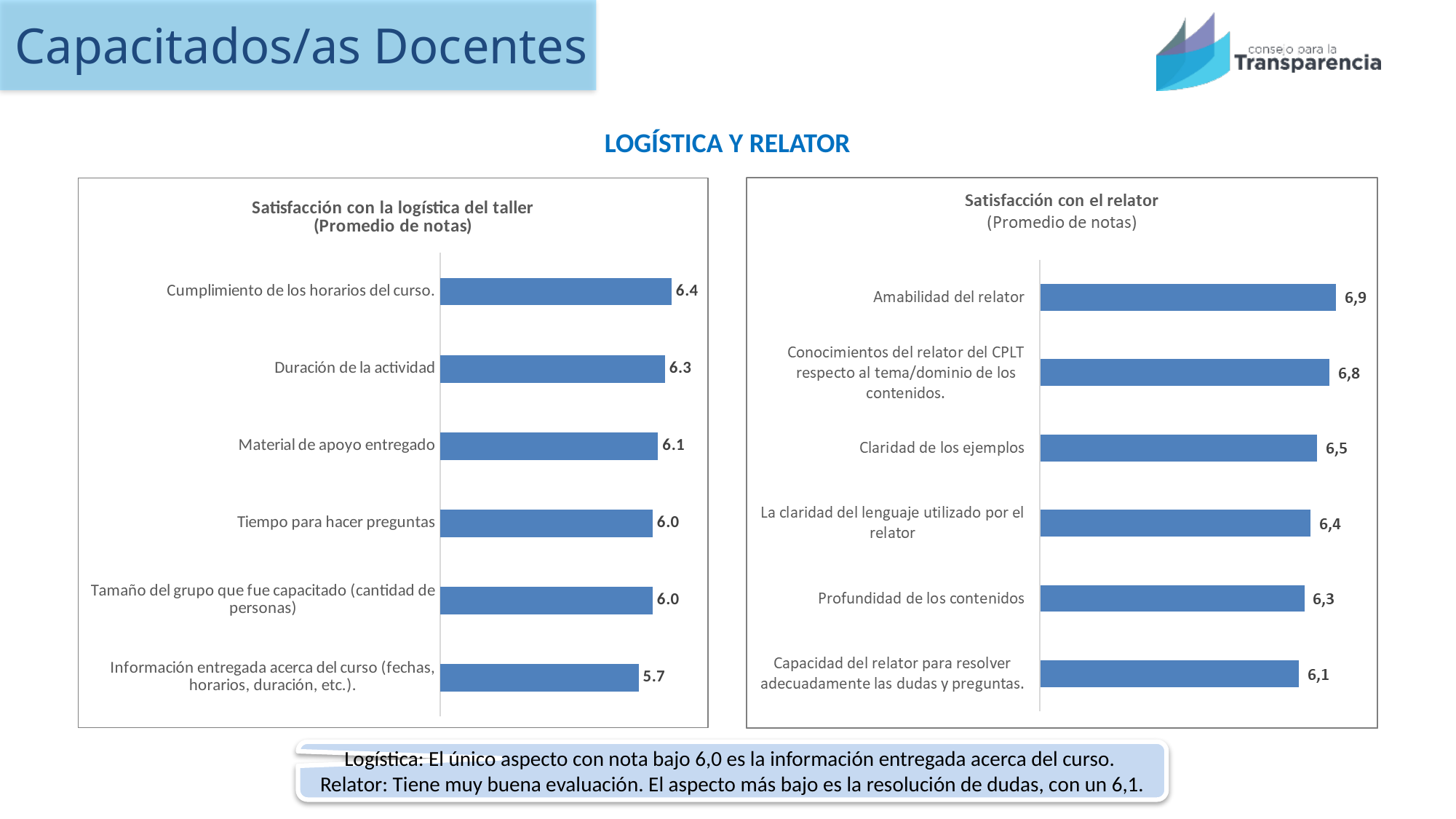
In the 'Satisfacción con el relator' chart, what is the difference between 'Amabilidad del relator' and 'Capacidad del relator para resolver adecuadamente las dudas y preguntas.'? 0,8 In the 'Satisfacción con el relator' chart, what is the value for 'Profundidad de los contenidos'? 6,3 In the 'Satisfacción con la logística del taller' chart, which category has the highest value? Cumplimiento de los horarios del curso. What type of chart is the 'Satisfacción con el relator' chart? Bar chart In the 'Satisfacción con el relator' chart, which category has the lowest value? Capacidad del relator para resolver adecuadamente las dudas y preguntas. In the 'Satisfacción con la logística del taller' chart, what is the difference between 'Duración de la actividad' and 'Información entregada acerca del curso (fechas, horarios, duración, etc.).'? 0.6 In the 'Satisfacción con la logística del taller' chart, what is the value for 'Cumplimiento de los horarios del curso.'? 6.4 In the 'Satisfacción con el relator' chart, what is the value for 'Amabilidad del relator'? 6,9 In the 'Satisfacción con la logística del taller' chart, which category has the lowest value? Información entregada acerca del curso (fechas, horarios, duración, etc.). In the 'Satisfacción con el relator' chart, which is larger: 'Claridad de los ejemplos' or 'La claridad del lenguaje utilizado por el relator'? Claridad de los ejemplos In the 'Satisfacción con la logística del taller' chart, how many categories are shown? 6 In the 'Satisfacción con la logística del taller' chart, what is the value for 'Material de apoyo entregado'? 6.1